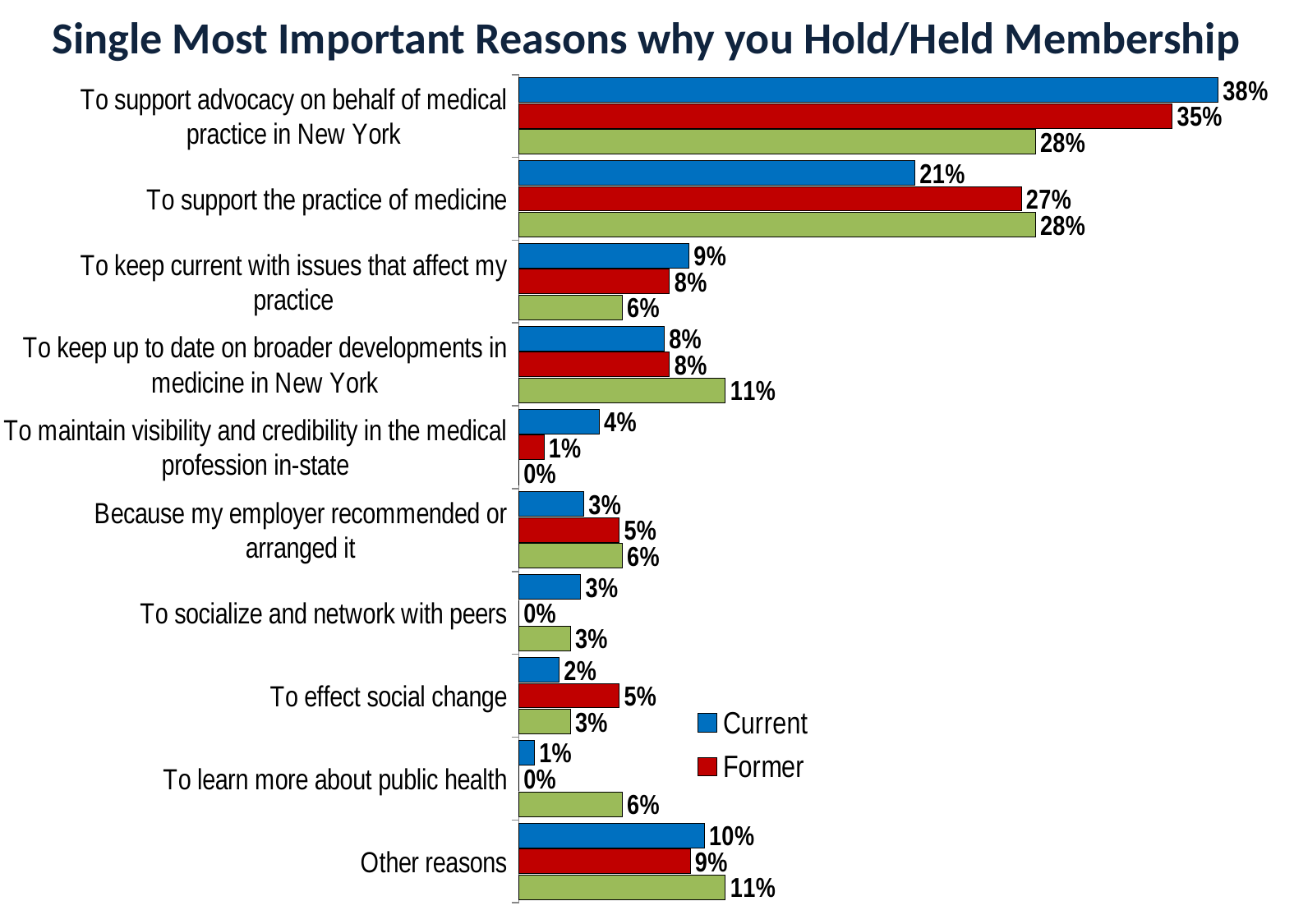
What is the Current value for 'Other reasons'? 10% For 'To effect social change', which is larger, the Current or the Former value? Former What percentage of Former members chose 'To support the practice of medicine'? 27% What percentage of Current members chose 'To support advocacy on behalf of medical practice in New York'? 38% How many reasons (categories) are listed on the chart? 10 What kind of chart is shown on the slide? Bar chart What is the title of the chart? Single Most Important Reasons why you Hold/Held Membership Which reason has the lowest Current value? To learn more about public health For 'To support the practice of medicine', which is larger, the Current or the Former value? Former Which reason has the highest Current value? To support advocacy on behalf of medical practice in New York How many series does the legend list? 2 What is the difference between the Current and Former values for 'To support advocacy on behalf of medical practice in New York'? 3%